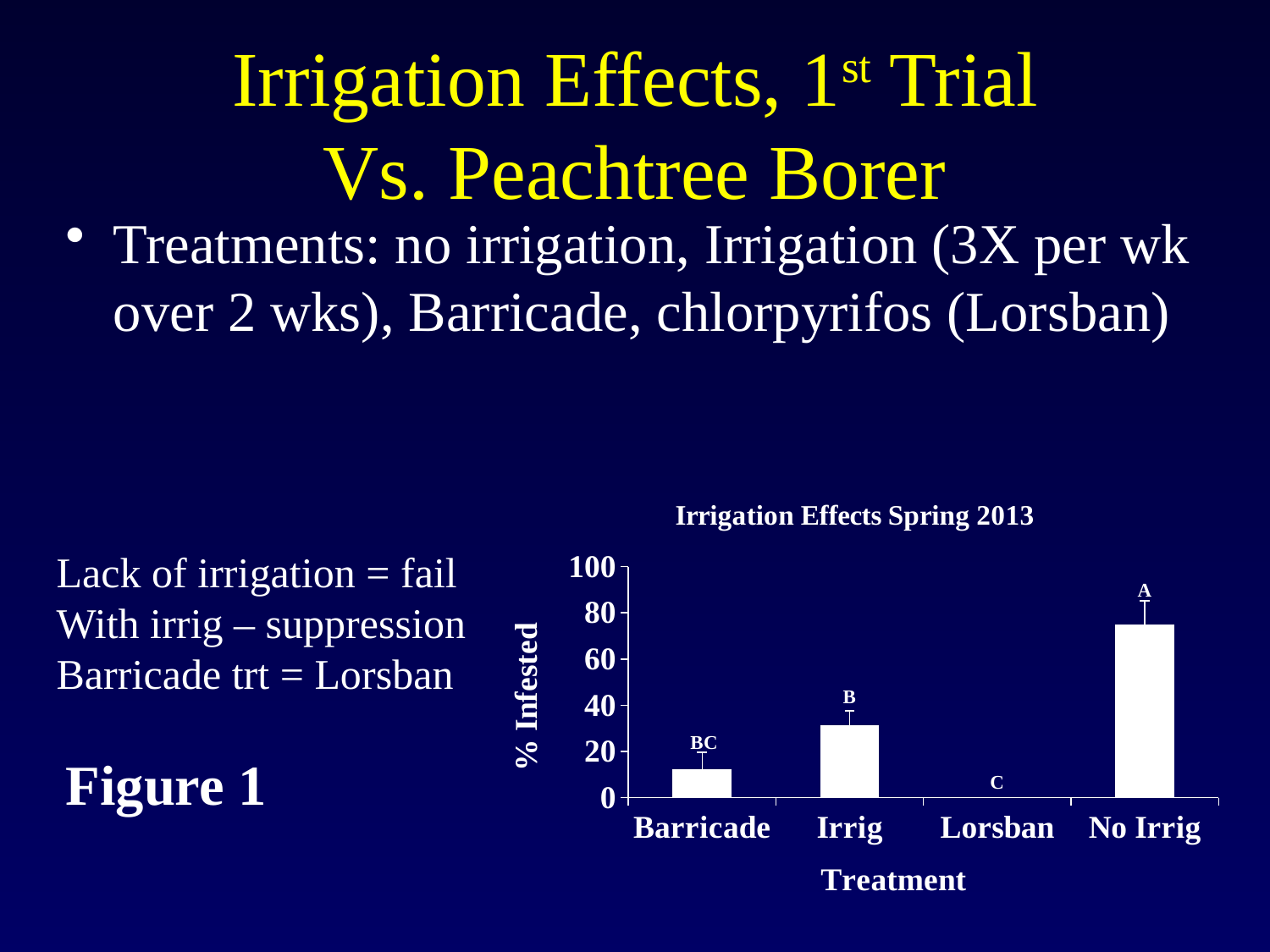
Which treatment has the highest % Infested in the chart? No Irrig What is the title of the chart? Irrigation Effects Spring 2013 Which treatment has a higher % Infested, Irrig or Barricade? Irrig What kind of chart is shown on the slide? bar chart What is the label on the y axis of the chart? % Infested Is the % Infested for No Irrig greater or less than 60? greater Is the % Infested for Irrig greater or less than 40? less Which treatment has a higher % Infested, No Irrig or Irrig? No Irrig How many treatment categories are plotted on the x axis of the chart? 4 Which treatment has the lowest % Infested in the chart? Lorsban Is the % Infested for Barricade greater or less than 20? less